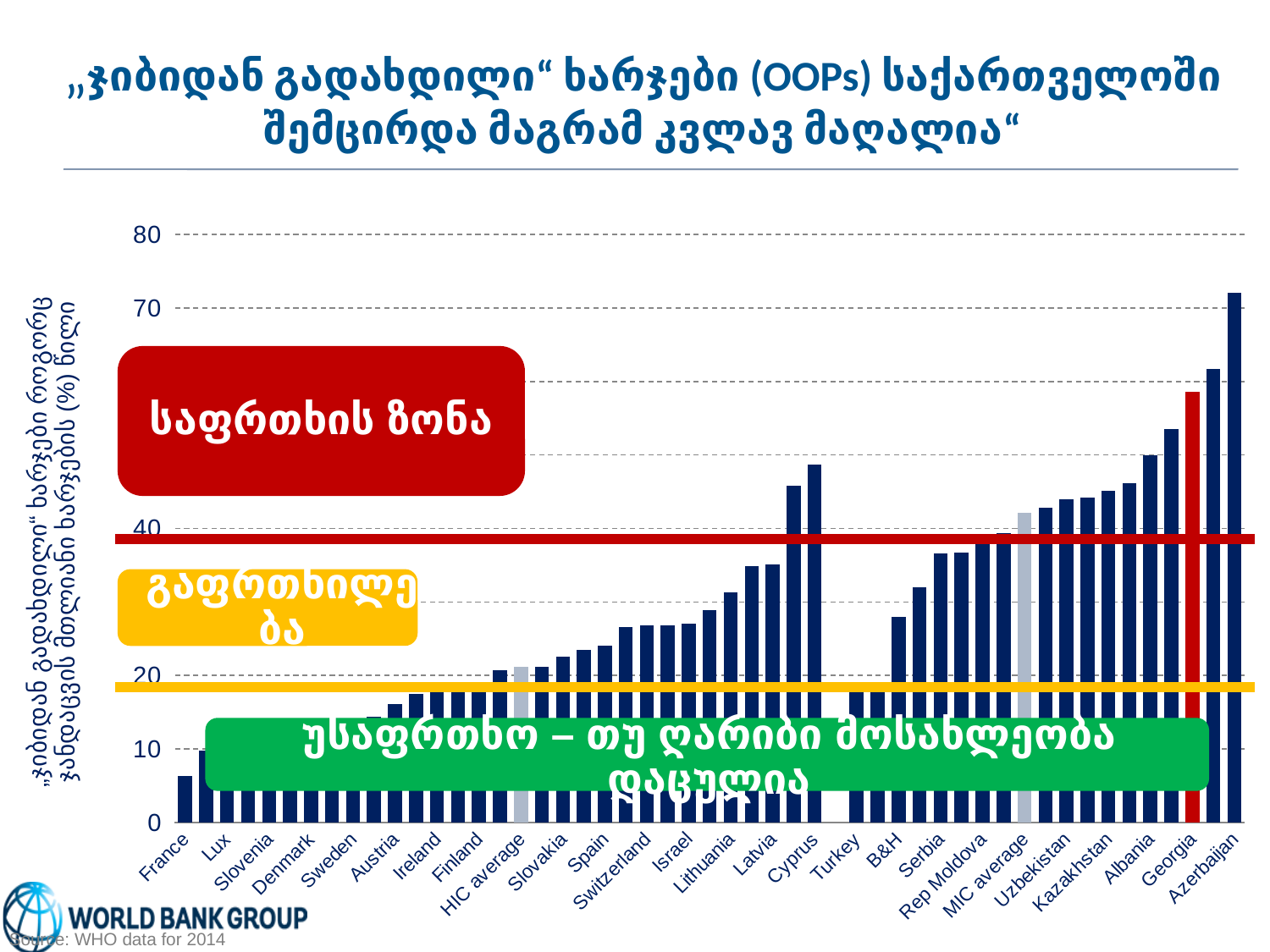
Is the value for Kazakhstan greater or less than 40? greater Is the value for Cyprus greater or less than 40? greater Is the value for Turkey greater or less than 20? less What kind of chart is shown on the slide? bar chart What colour is the bar for Georgia? red Which labeled country has the highest value in the chart? Azerbaijan Which has the larger value, Georgia or Azerbaijan? Azerbaijan Which has the larger value, Turkey or Serbia? Serbia Which labeled country has the lowest value in the chart? France